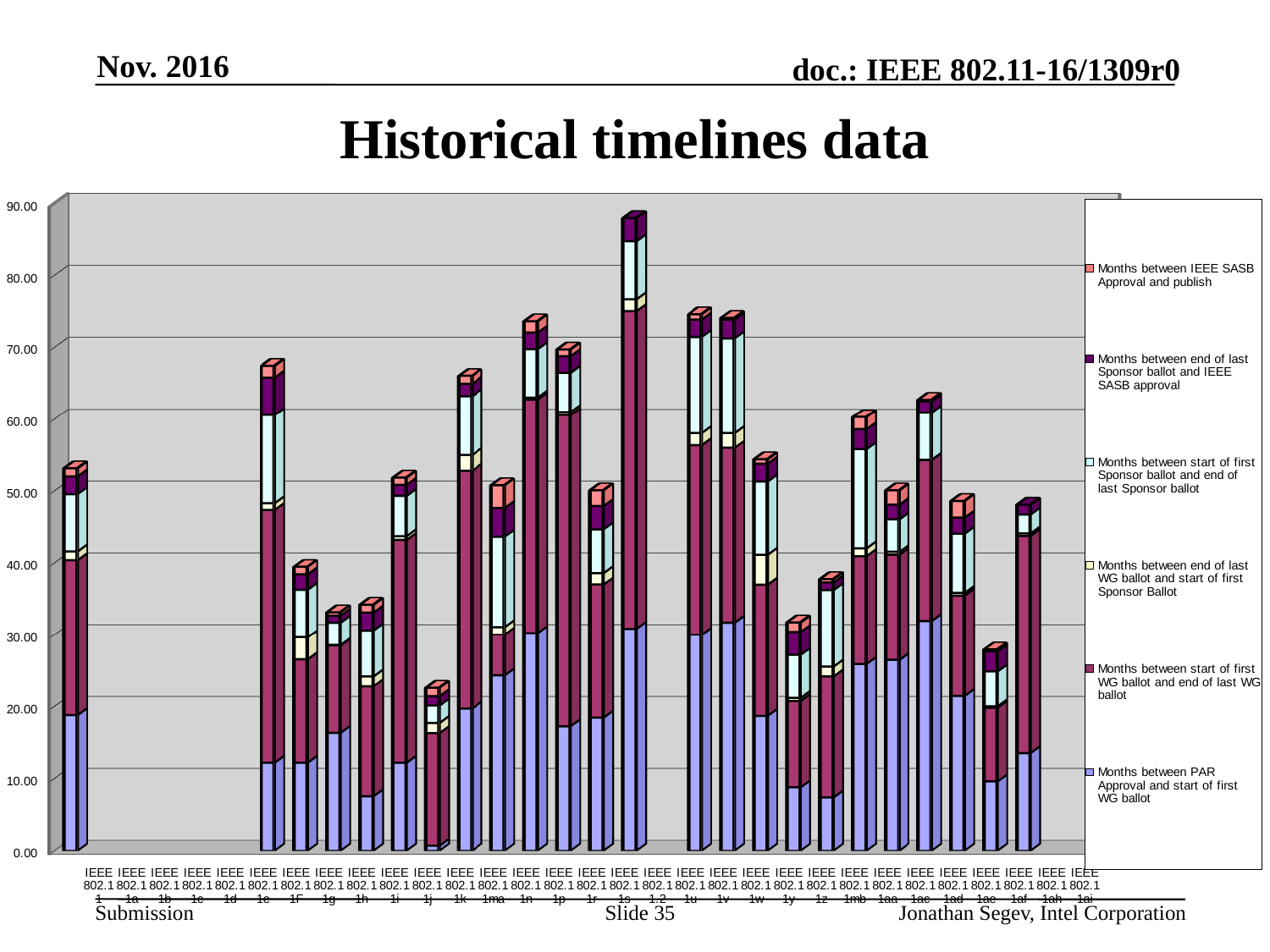
How many series does the legend list? 6 Is the total for IEEE 802.1 1j greater or less than 30.00? less Is the total for IEEE 802.1 1y greater or less than 40.00? less Which has the taller stacked bar, IEEE 802.1 1e or IEEE 802.1 1F? IEEE 802.1 1e Is the total for IEEE 802.1 1s greater or less than 80.00? greater Which series is listed last (at the bottom) in the legend? Months between PAR Approval and start of first WG ballot Which has the taller stacked bar, IEEE 802.1 1ae or IEEE 802.1 1ac? IEEE 802.1 1ac Which category has the tallest stacked bar? IEEE 802.1 1s What kind of chart is shown on the slide? Stacked bar chart What is the title of the chart? Historical timelines data